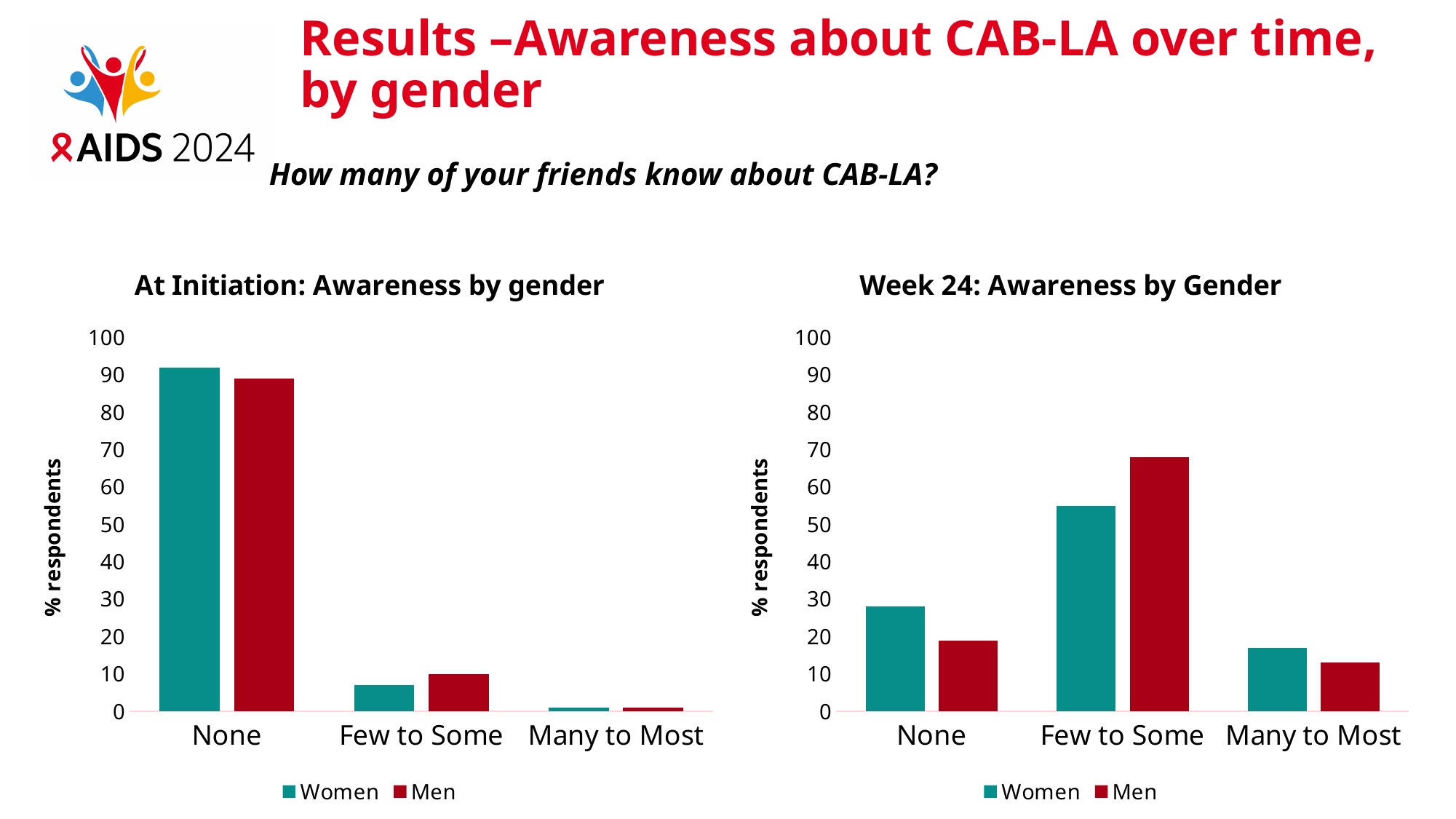
In the 'Week 24: Awareness by Gender' chart, which category has the highest value for Men? Few to Some In the 'At Initiation: Awareness by gender' chart, is the value for Men in the Few to Some category greater or less than 20? less In the 'Week 24: Awareness by Gender' chart, how many series does the legend list? 2 In the 'At Initiation: Awareness by gender' chart, how many categories are shown on the x axis? 3 In the 'At Initiation: Awareness by gender' chart, which category has the highest value for Women? None In the 'Week 24: Awareness by Gender' chart, which is larger in the None category, Women or Men? Women In the 'Week 24: Awareness by Gender' chart, which is larger in the Few to Some category, Women or Men? Men In the 'At Initiation: Awareness by gender' chart, is the value for Women in the None category greater or less than 80? greater What is the y-axis label on the 'Week 24: Awareness by Gender' chart? % respondents In the 'Week 24: Awareness by Gender' chart, which category has the lowest value for Men? Many to Most In the 'Week 24: Awareness by Gender' chart, is the value for Men in the Few to Some category greater or less than 60? greater What kind of chart is the 'At Initiation: Awareness by gender' chart? bar chart